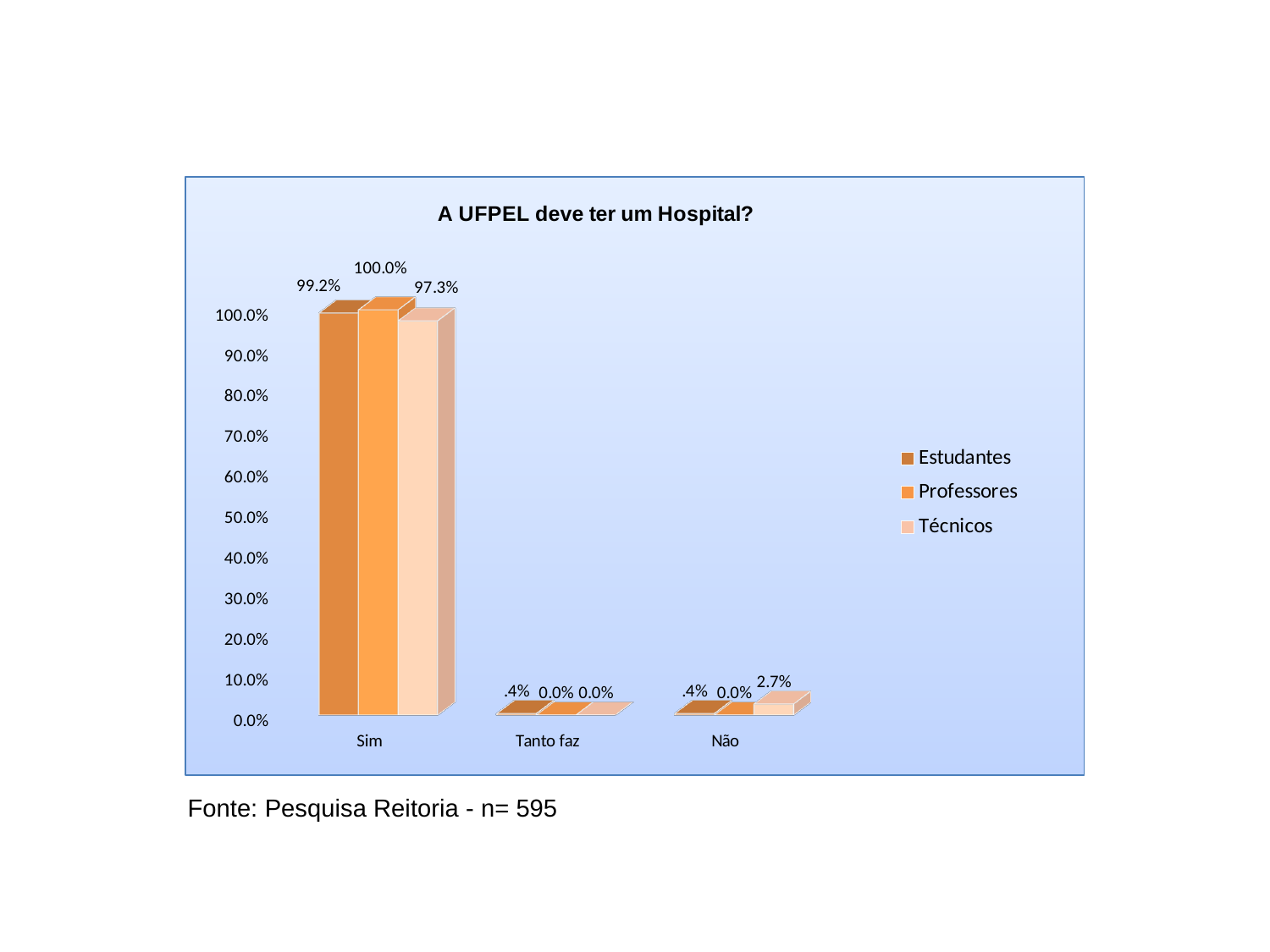
What is the difference between the Professores and Técnicos values in the Sim category? 2.7% What is the value for Professores in the Sim category? 100.0% Which series has the lowest value in the Sim category? Técnicos What is the value for Técnicos in the Não category? 2.7% What kind of chart is shown on the slide? Bar chart How many series does the legend list? 3 What is the title of the chart? A UFPEL deve ter um Hospital? What is the value for Técnicos in the Sim category? 97.3% How many categories are shown on the x axis? 3 Which series has the highest value in the Sim category? Professores What is the value for Estudantes in the Sim category? 99.2% Which is larger in the Não category: the value for Estudantes or the value for Técnicos? Técnicos